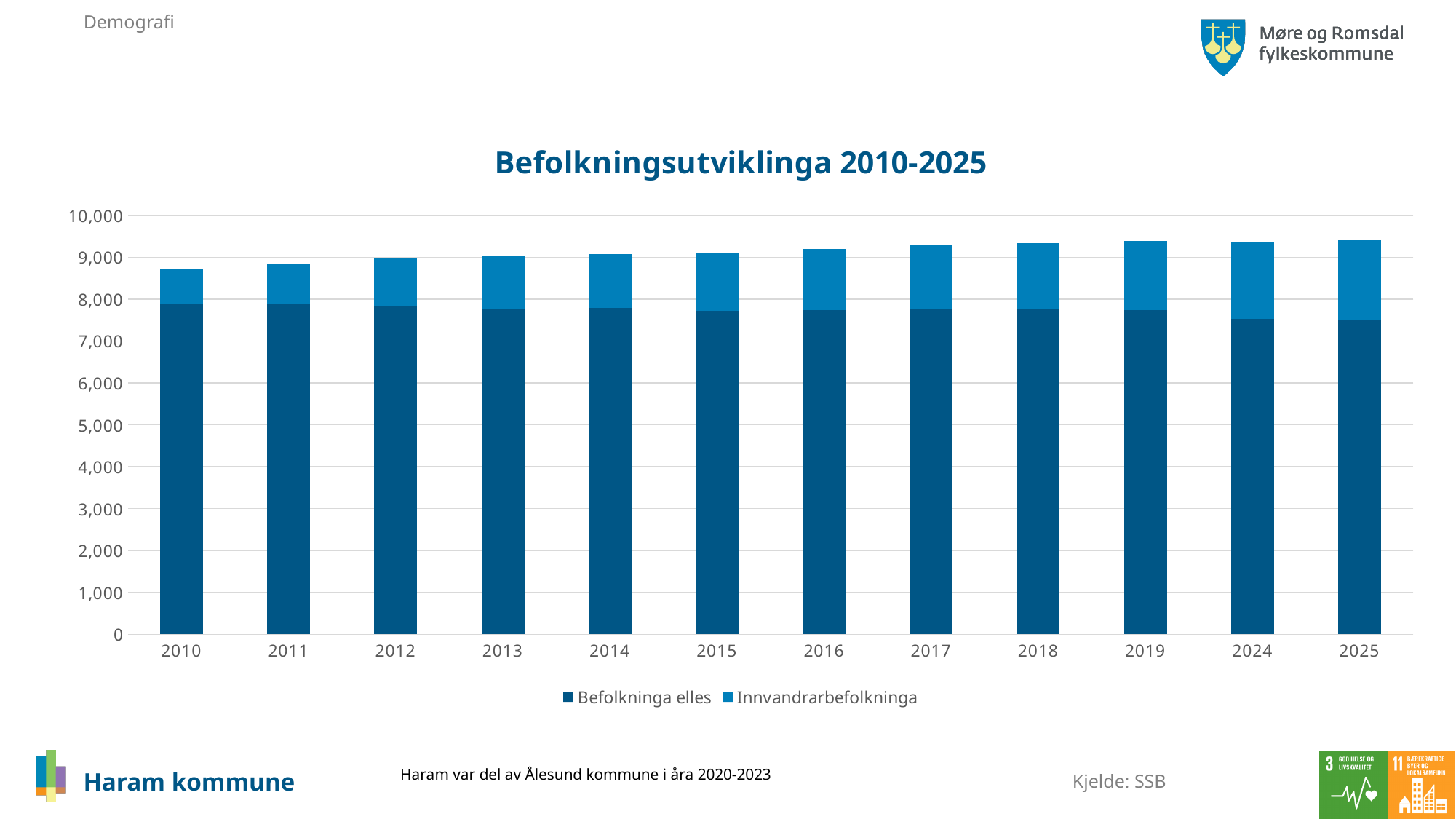
Does the total population generally rise or fall from 2010 to 2025? rise How many series does the legend list? 2 What kind of chart is shown on the slide? Stacked bar chart Which year has the lowest total population bar? 2010 Which series is shown in the lighter blue colour? Innvandrarbefolkninga Is the total bar for 2025 greater or less than 9,000? greater Is the Befolkninga elles value for 2025 greater or less than 8,000? less Which year has the smallest Innvandrarbefolkninga segment? 2010 Is the total bar for 2010 greater or less than 8,000? greater What is the title of the chart? Befolkningsutviklinga 2010-2025 How many years (bars) are shown on the x axis? 12